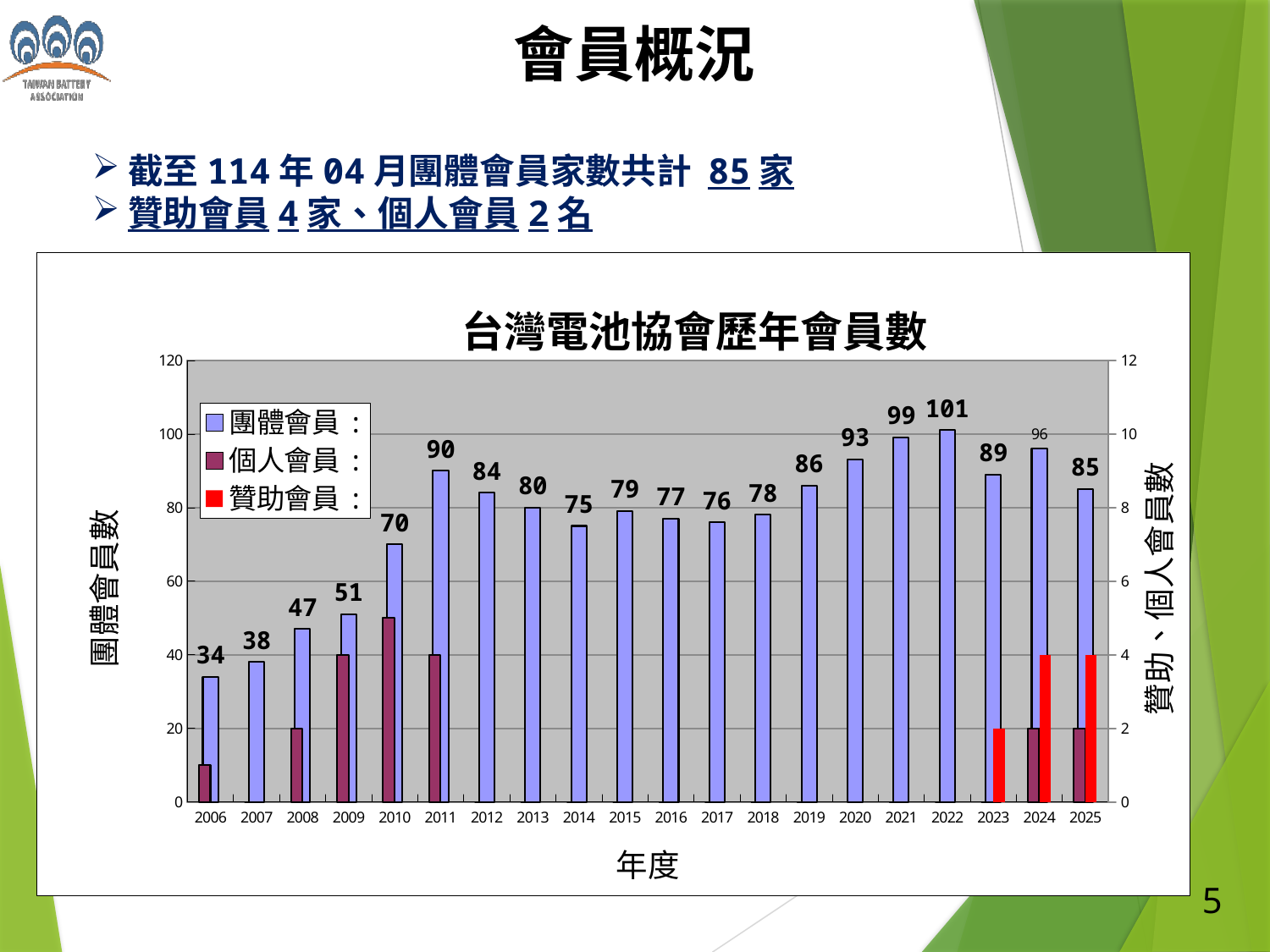
Which year has the lowest 團體會員 value? 2006 How many series does the legend list? 3 What kind of chart is this? bar chart Which is larger, the 團體會員 value for 2011 or for 2019? 2011 Is the 個人會員 value for 2010 greater or less than 4 on the right axis? greater What is the value for 團體會員 in 2022? 101 Which year has the highest 團體會員 value? 2022 What is the difference between the 團體會員 values for 2024 and 2025? 11 Is the 贊助會員 value for 2024 greater or less than 2 on the right axis? greater What is the value for 團體會員 in 2025? 85 What is the value for 團體會員 in 2010? 70 How many years are shown on the x axis? 20